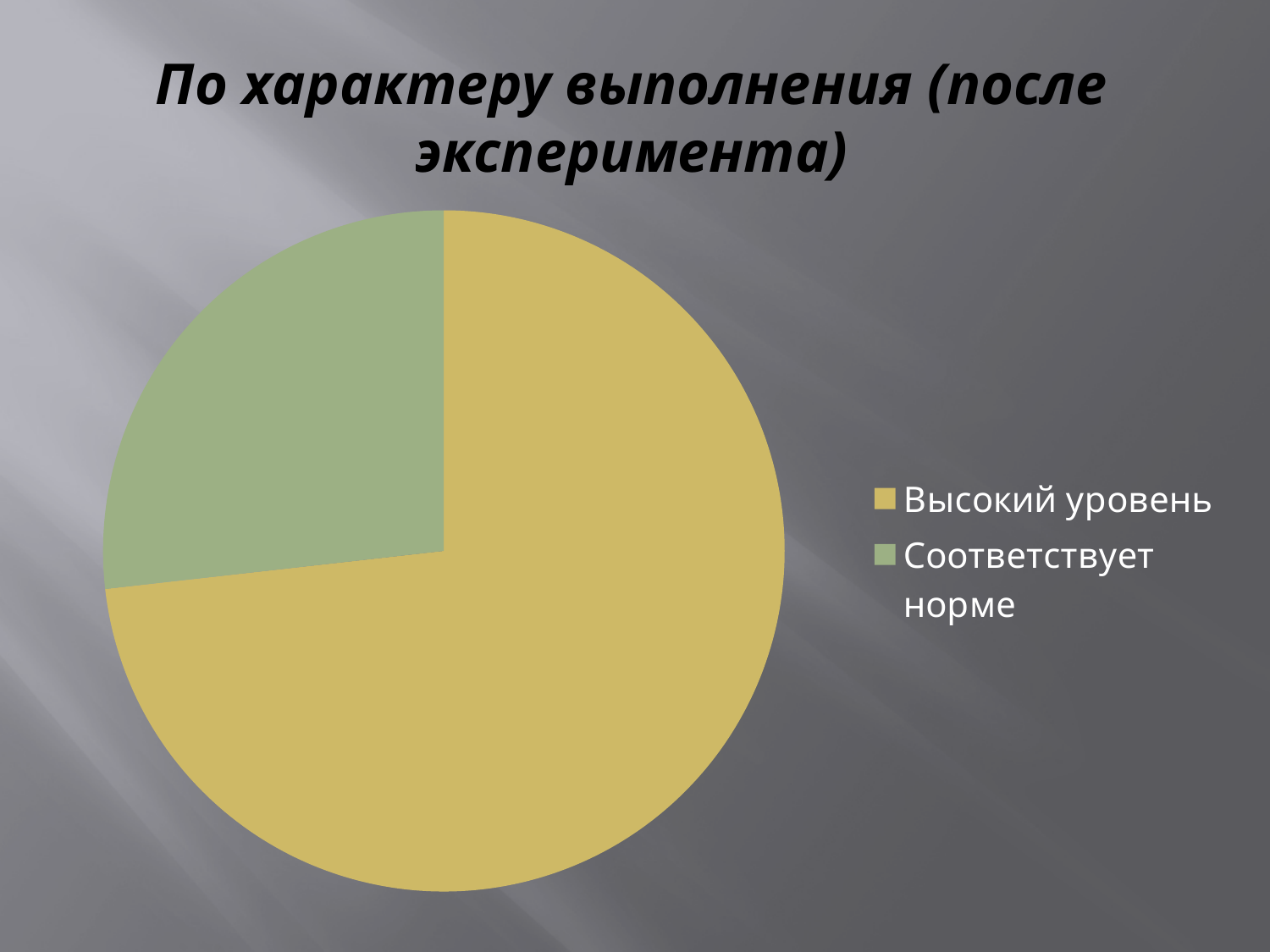
What is the title of the chart? По характеру выполнения (после эксперимента) Which category has the largest slice of the pie? Высокий уровень What kind of chart is shown on the slide? pie chart How many slices does the pie chart have? 2 How many entries does the legend list? 2 Which slice is larger: Высокий уровень or Соответствует норме? Высокий уровень What colour is the slice for Соответствует норме? green Which category has the smallest slice of the pie? Соответствует норме